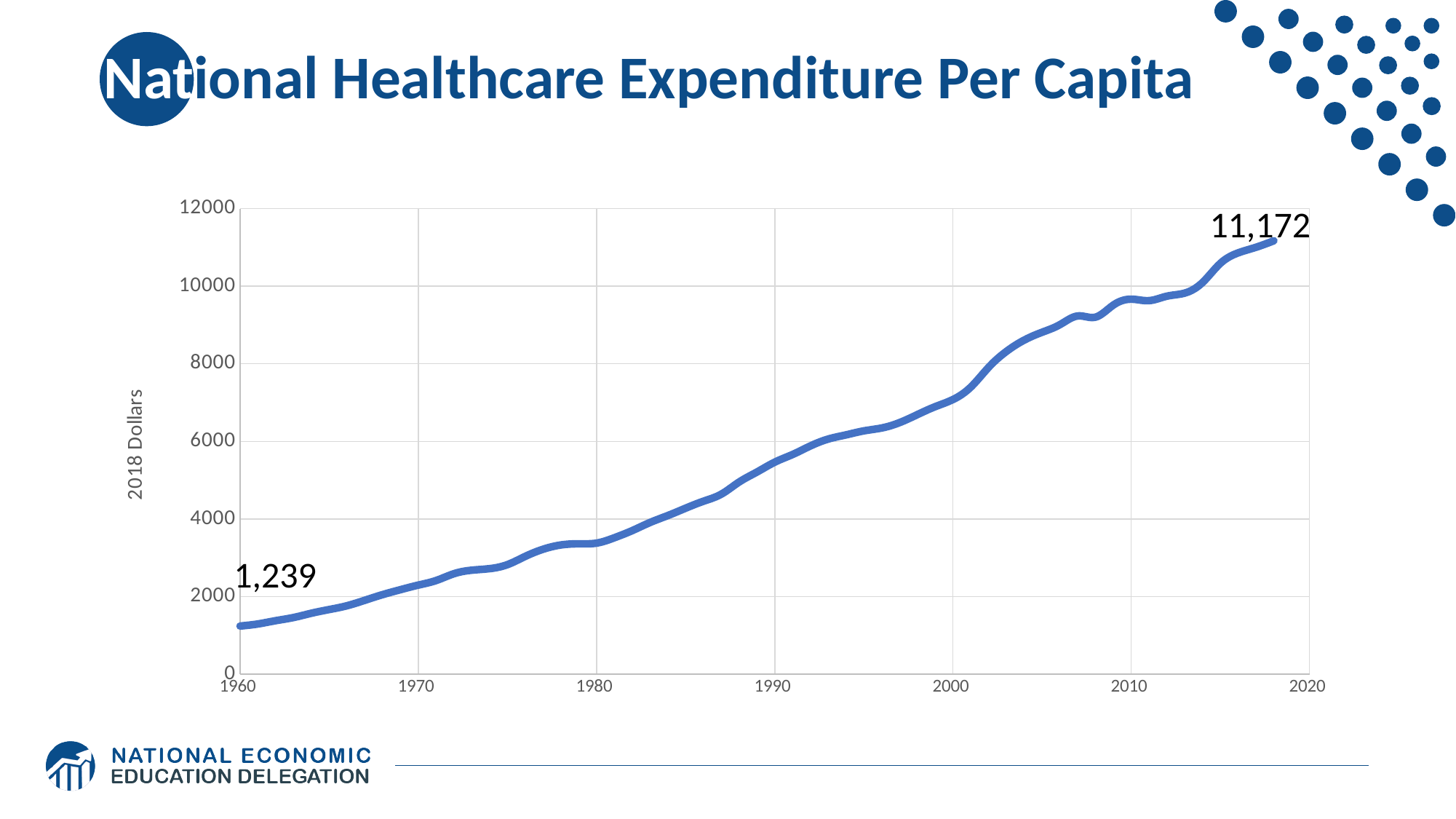
What is the label on the vertical axis? 2018 Dollars What is the difference between the labelled end value and the labelled 1960 value? 9,933 Is the value for 2010 greater or less than 8000? greater What kind of chart is shown on the slide? line chart Does national healthcare expenditure per capita rise or fall from 1960 to the end of the series? rise What is the lowest value labelled on the chart? 1,239 Is the value for 1980 greater or less than 2000? greater What is the highest value labelled on the chart? 11,172 Which year has the larger value, 1980 or 2000? 2000 Is the value for 1990 greater or less than 6000? less What is the value labelled at the start of the line, in 1960? 1,239 What is the value labelled at the end of the line? 11,172